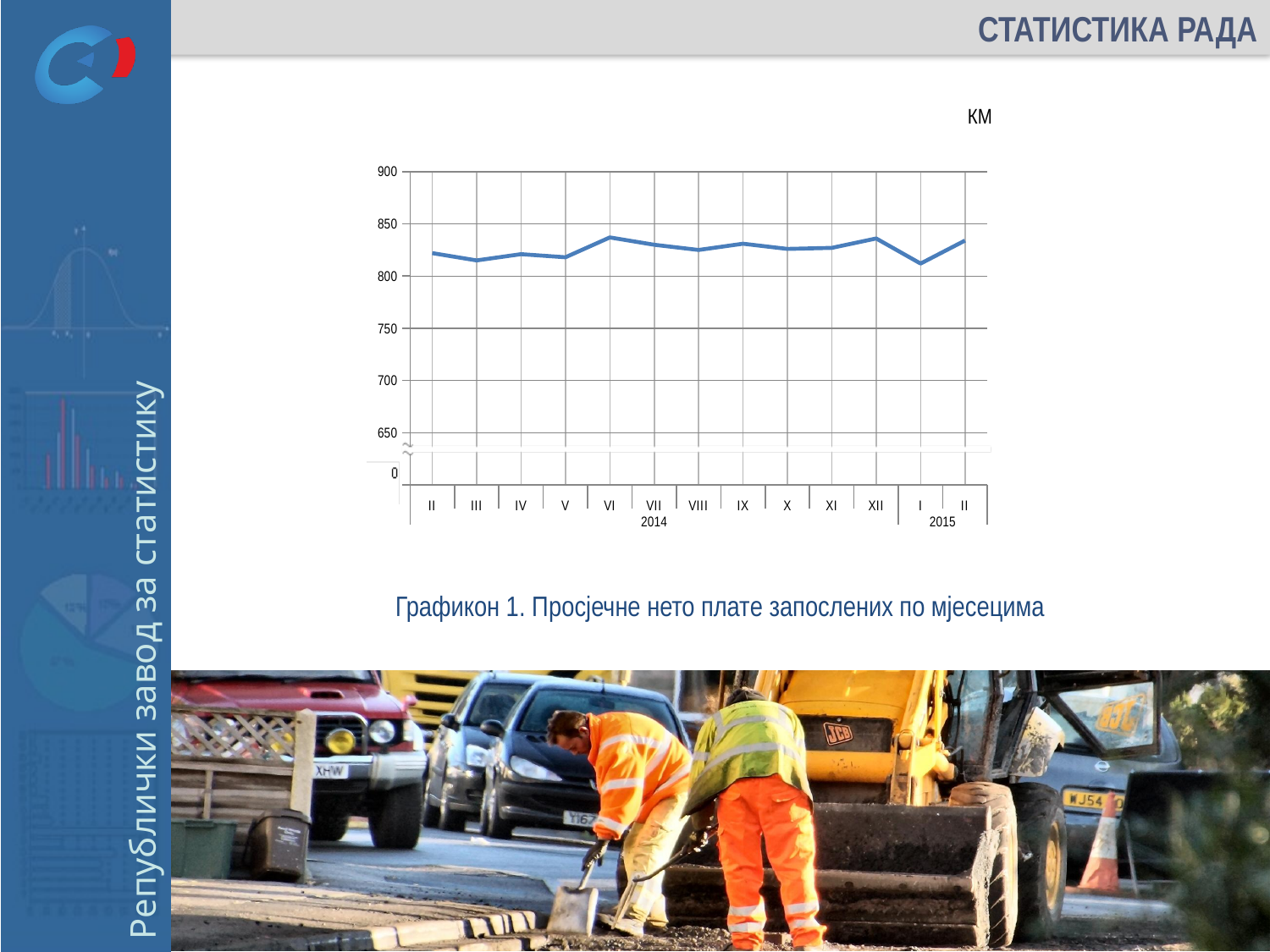
What is the title given below the chart? Графикон 1. Просјечне нето плате запослених по мјесецима What unit is indicated above the chart? KM Is the value for III 2014 greater or less than 750? greater How many monthly data points are plotted on the chart? 13 What kind of chart is shown on the slide? line chart Is the value for XII 2014 greater or less than 900? less Is the value for I 2015 greater or less than 850? less Which is larger, the value for I 2015 or the value for II 2015? II 2015 Does the line rise or fall from I 2015 to II 2015? rise Does the line rise or fall from XII 2014 to I 2015? fall Which is larger, the value for VI 2014 or the value for III 2014? VI 2014